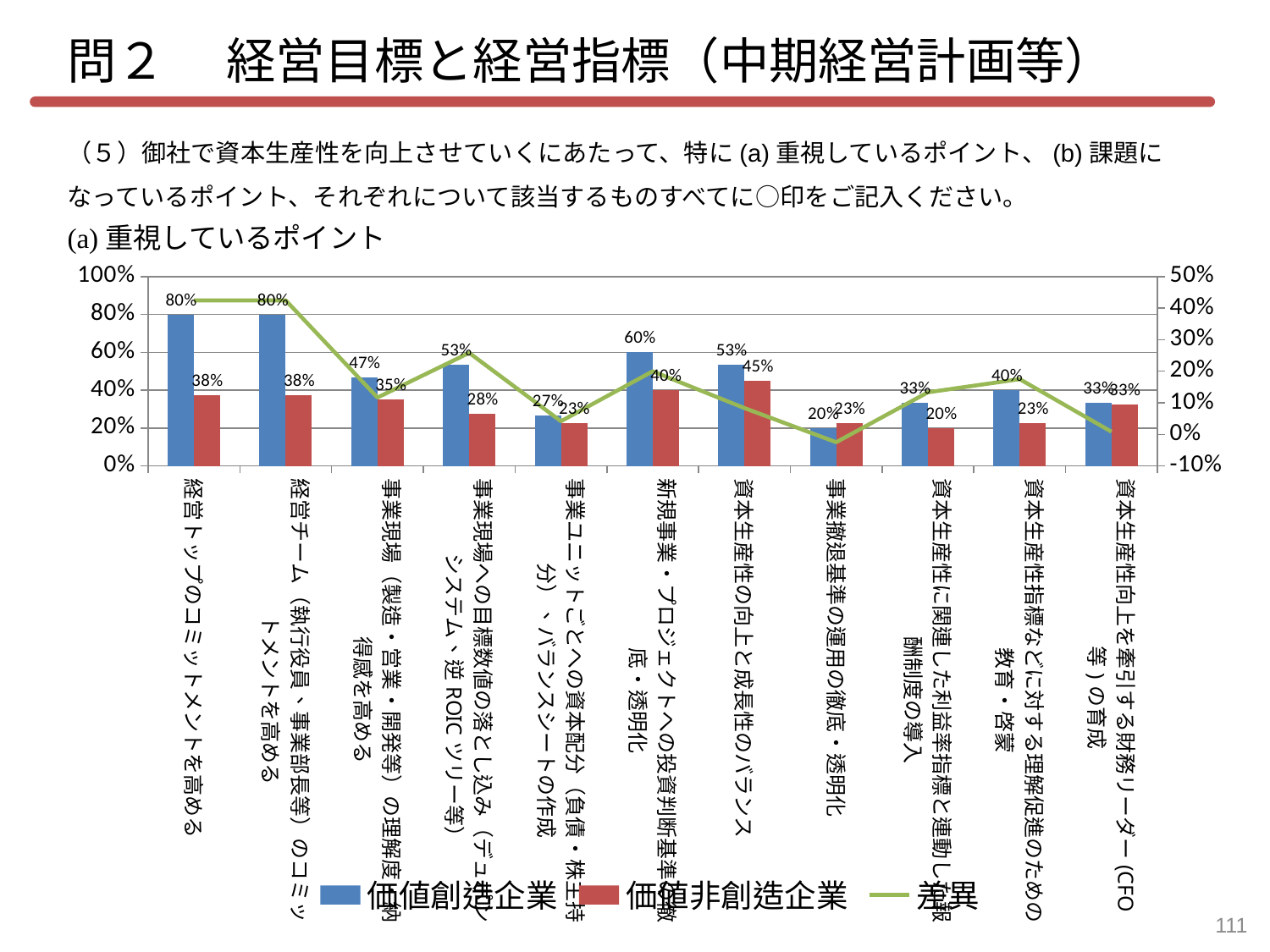
For 事業撤退基準の運用の徹底・透明化, which is larger: 価値創造企業 or 価値非創造企業? 価値非創造企業 Which series is drawn as a line in the chart? 差異 How many series does the chart legend list? 3 What is the difference between the 価値創造企業 and 価値非創造企業 values for 経営トップのコミットメントを高める? 42 percentage points What is the value for 価値非創造企業 for 資本生産性の向上と成長性のバランス? 45% What is the value for 価値創造企業 for 新規事業・プロジェクトへの投資判断基準の徹底・透明化? 60% What kind of chart is shown on the slide? A combined bar and line chart Which category has the lowest 価値非創造企業 value? 資本生産性に関連した利益率指標と連動した報酬制度の導入 How many categories are shown on the x axis of the chart? 11 What is the value for 価値創造企業 for 事業撤退基準の運用の徹底・透明化? 20% Is the 差異 line value for 経営トップのコミットメントを高める greater or less than 30% on the right-hand axis? greater Which category has the highest 価値非創造企業 value? 資本生産性の向上と成長性のバランス